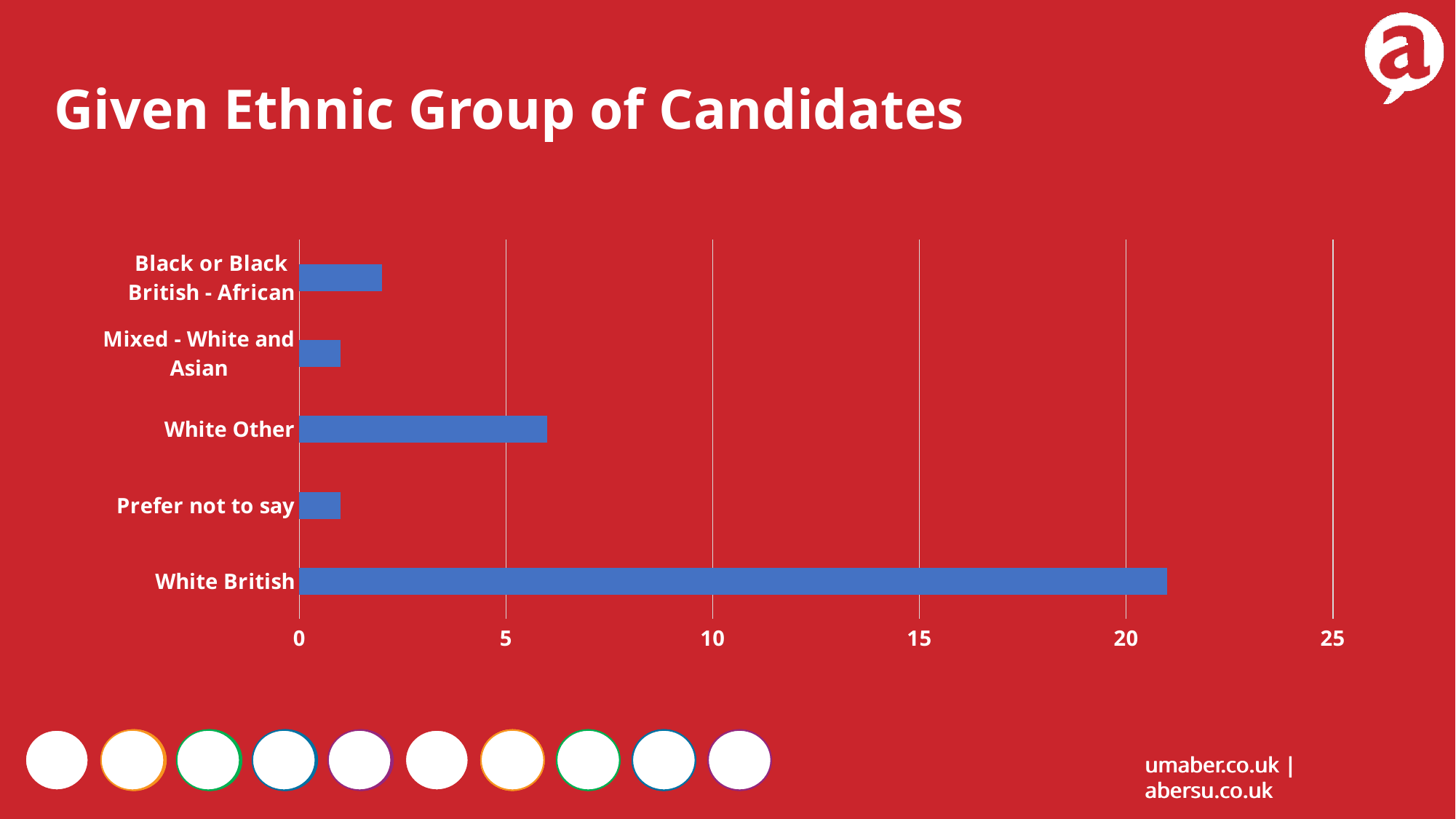
Is the value for Black or Black British - African greater or less than 5? less What kind of chart is shown on the slide? bar chart Is the value for White Other greater or less than 10? less Which category has the highest value? White British Is the value for Prefer not to say greater or less than 5? less Which is larger, the value for White Other or the value for Black or Black British - African? White Other What is the highest value shown on the horizontal axis? 25 What is the title of the chart? Given Ethnic Group of Candidates How many ethnic group categories are plotted in the chart? 5 Which is larger, the value for White British or the value for White Other? White British